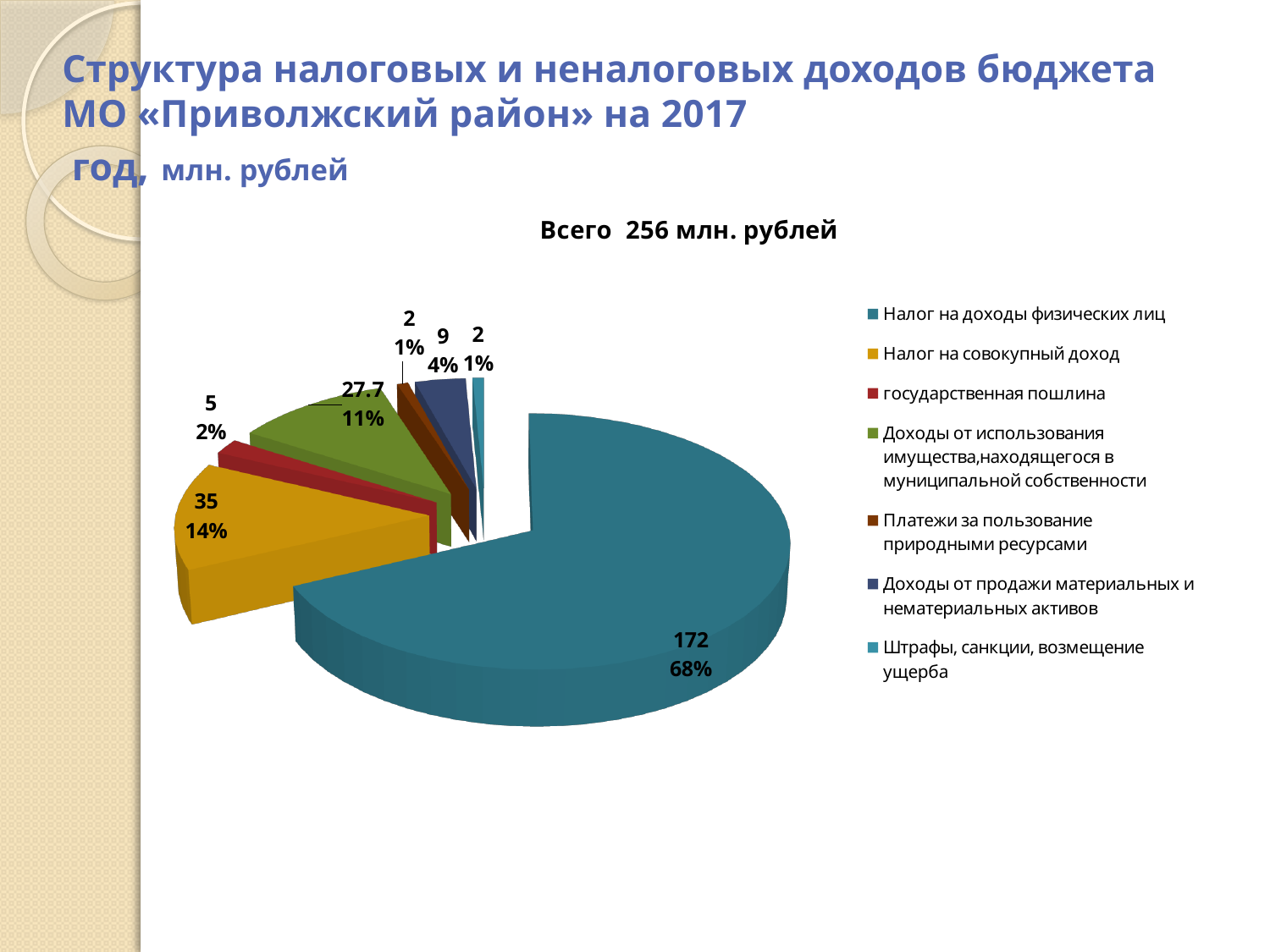
What is the value for "Доходы от использования имущества, находящегося в муниципальной собственности"? 27.7 What share of the pie does "Налог на доходы физических лиц" represent? 68% What is the value for "Налог на доходы физических лиц"? 172 What is the value for "Доходы от продажи материальных и нематериальных активов"? 9 How many categories does the legend list? 7 Which category has the largest slice of the pie? Налог на доходы физических лиц What kind of chart is shown on the slide? Pie chart What is the difference between the values for "Налог на доходы физических лиц" and "Налог на совокупный доход"? 137 What share of the pie does "Налог на совокупный доход" represent? 14% Which is larger, the value for "государственная пошлина" or the value for "Доходы от продажи материальных и нематериальных активов"? Доходы от продажи материальных и нематериальных активов What is the value for "Налог на совокупный доход"? 35 What is the title of the chart? Всего 256 млн. рублей